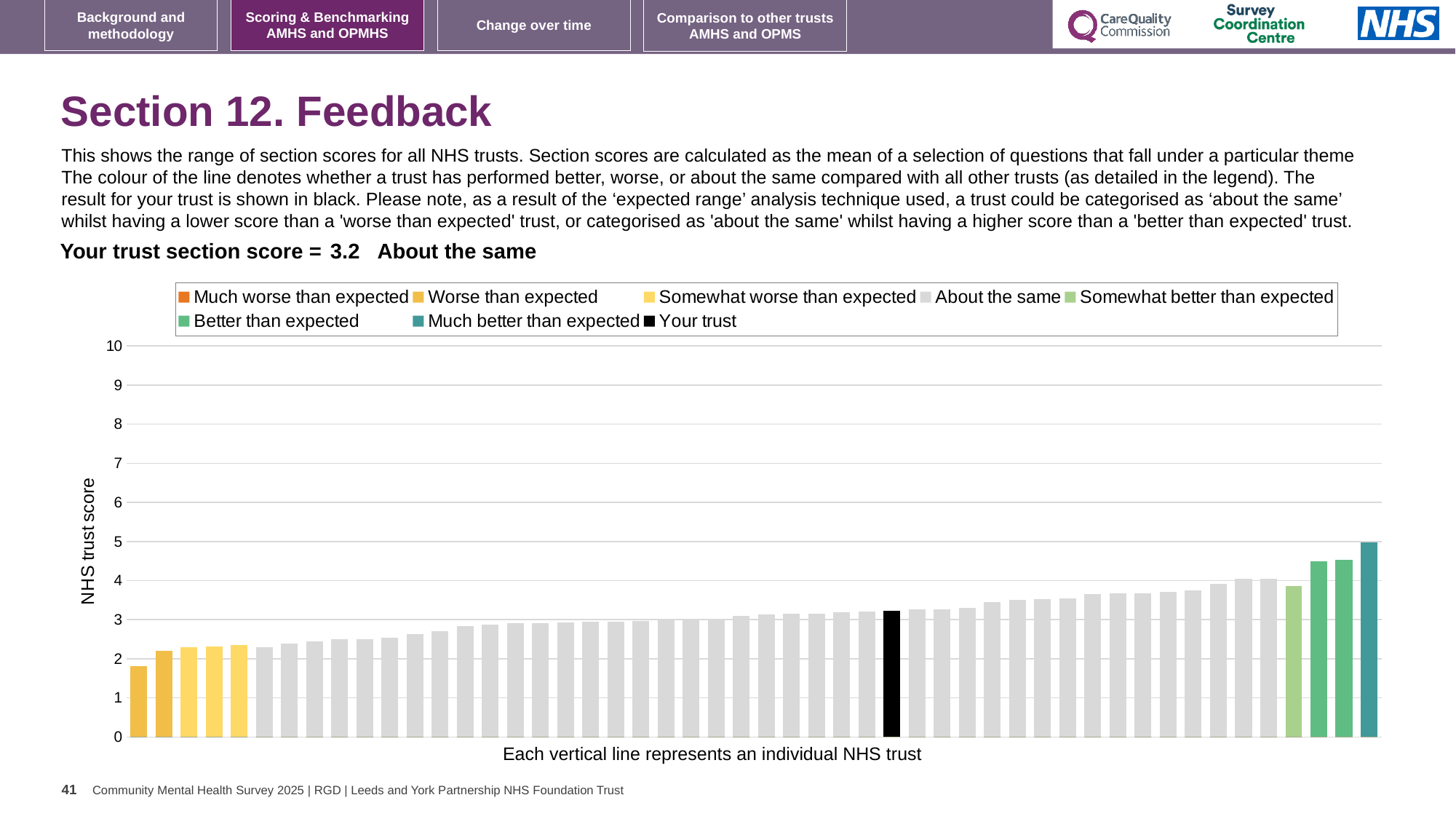
Is the value for your trust (the black bar) greater or less than 4? less What is the section score for your trust shown on the slide? 3.2 Is the value of the shortest bar in the chart greater or less than 2? less Is the value of the tallest bar in the chart greater or less than 4? greater What kind of chart is shown on the slide? bar chart What is the title of the y axis of the chart? NHS trust score Do the bar values rise or fall from left to right along the x axis? rise How many entries does the chart legend list? 8 What is the highest value shown on the y axis of the chart? 10